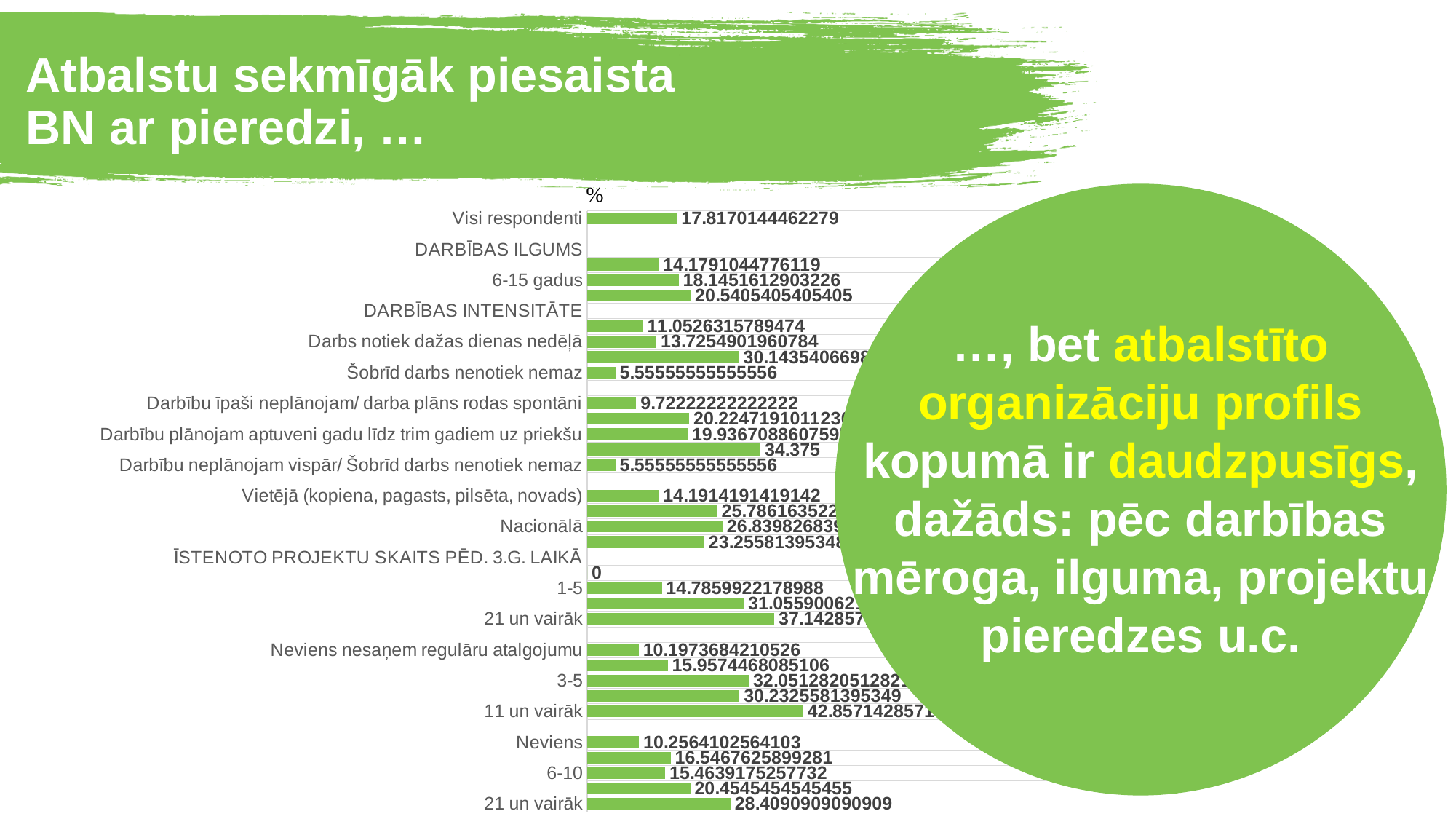
What is the value for Darbību īpaši neplānojam/ darba plāns rodas spontāni? 9.72222222222222 What is the value for Šobrīd darbs nenotiek nemaz? 5.55555555555556 What is the value for 6-15 gadus? 18.1451612903226 What is the value for Neviens nesaņem regulāru atalgojumu? 10.1973684210526 Which is larger, the value for Visi respondenti or the value for Šobrīd darbs nenotiek nemaz? Visi respondenti What is the value for Visi respondenti? 17.8170144462279 What is the value for Vietējā (kopiena, pagasts, pilsēta, novads)? 14.1914191419142 Which category has the highest value in the chart? 11 un vairāk What colour are the bars in the chart? green What kind of chart is shown on the slide? bar chart What is the value for 6-10? 15.4639175257732 What is the value for the last category, 21 un vairāk, at the bottom of the chart? 28.4090909090909